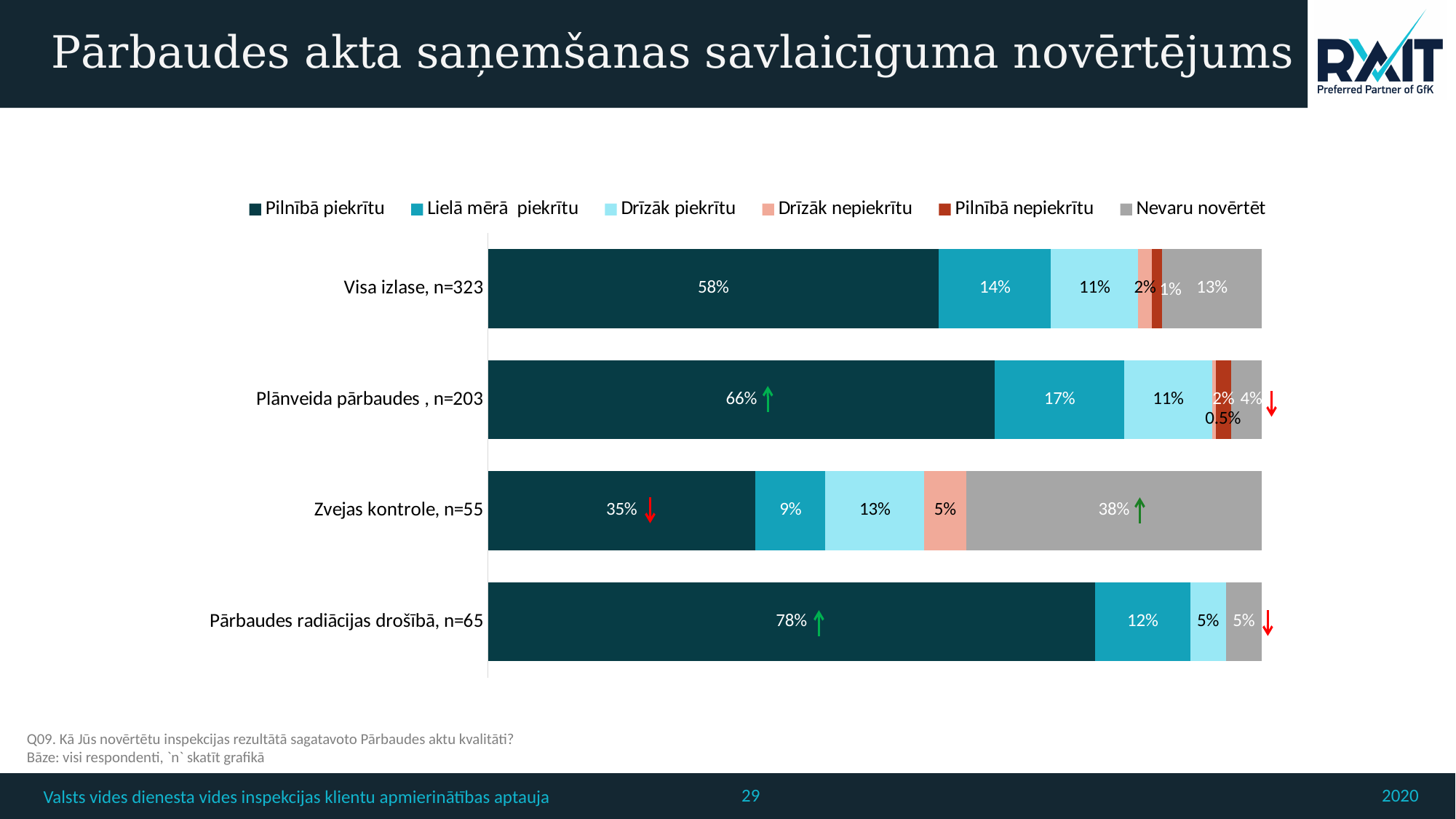
Which category has the highest 'Pilnībā piekrītu' value? Pārbaudes radiācijas drošībā, n=65 What is the difference between the 'Pilnībā piekrītu' values for 'Pārbaudes radiācijas drošībā, n=65' and 'Zvejas kontrole, n=55'? 43 percentage points How many series does the legend list? 6 What is the 'Nevaru novērtēt' value for 'Zvejas kontrole, n=55'? 38% What is the first series listed in the legend? Pilnībā piekrītu How many categories (bars) are shown in the chart? 4 What is the 'Lielā mērā piekrītu' value for 'Plānveida pārbaudes, n=203'? 17% Which category has the lowest 'Pilnībā piekrītu' value? Zvejas kontrole, n=55 What is the 'Pilnībā nepiekrītu' value for 'Plānveida pārbaudes, n=203'? 2% Which is larger: the 'Drīzāk piekrītu' value for 'Zvejas kontrole, n=55' or for 'Pārbaudes radiācijas drošībā, n=65'? Zvejas kontrole, n=55 What kind of chart is shown on the slide? Stacked bar chart What is the 'Pilnībā piekrītu' value for 'Visa izlase, n=323'? 58%